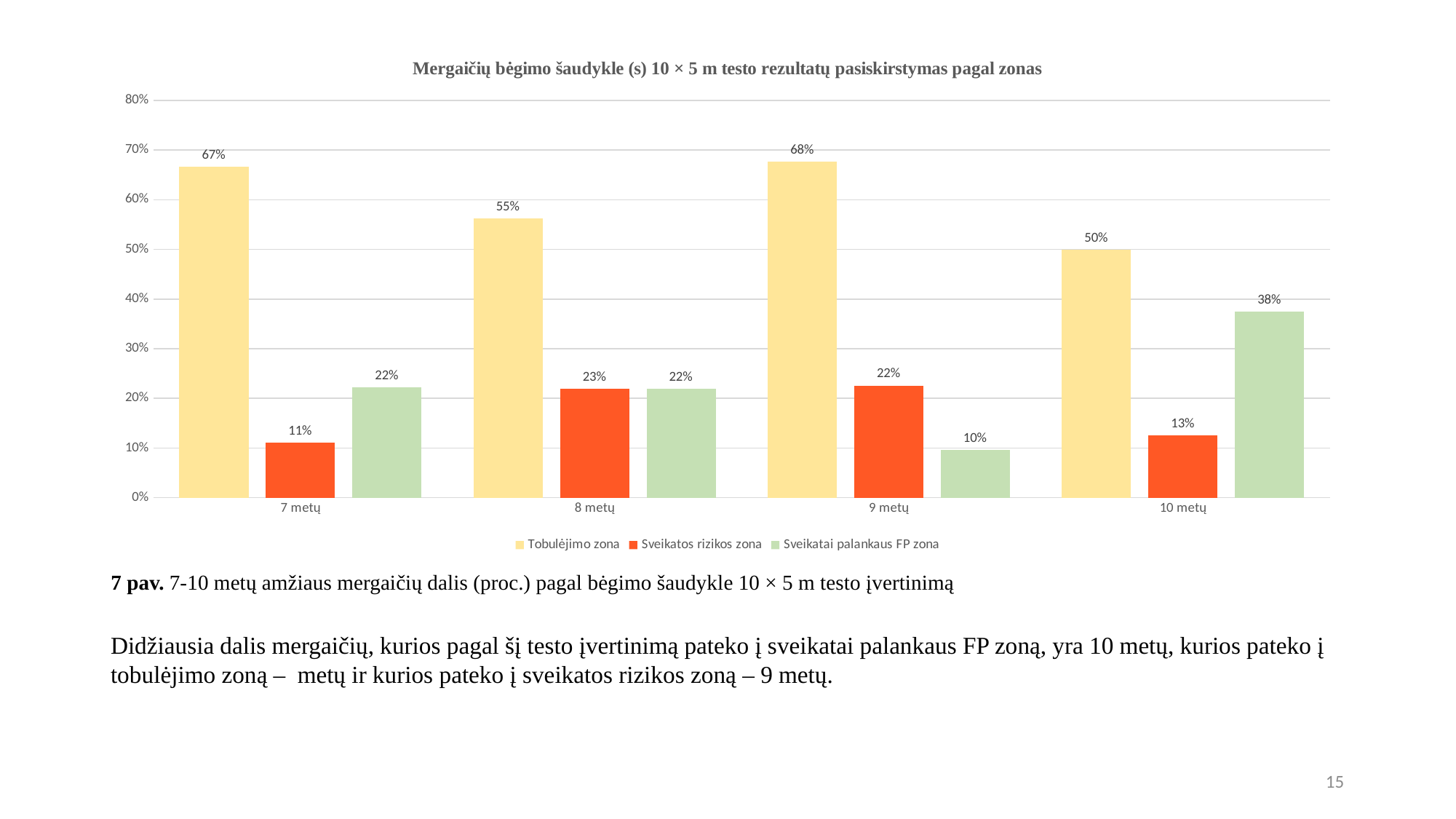
Which series is shown in red? Sveikatos rizikos zona What is the difference between the Tobulėjimo zona values for 7 metų and 8 metų? 12% What kind of chart is shown on the slide? Bar chart Which age group has the lowest value for Tobulėjimo zona? 10 metų What is the value for Tobulėjimo zona for 7 metų? 67% How many series does the legend list? 3 What is the value for Sveikatai palankaus FP zona for 9 metų? 10% What is the value for Sveikatos rizikos zona for 9 metų? 22% How many age groups are shown on the x axis? 4 What is the value for Sveikatai palankaus FP zona for 10 metų? 38% Which is larger: Sveikatos rizikos zona for 8 metų or Sveikatos rizikos zona for 10 metų? 8 metų Which age group has the highest value for Sveikatai palankaus FP zona? 10 metų